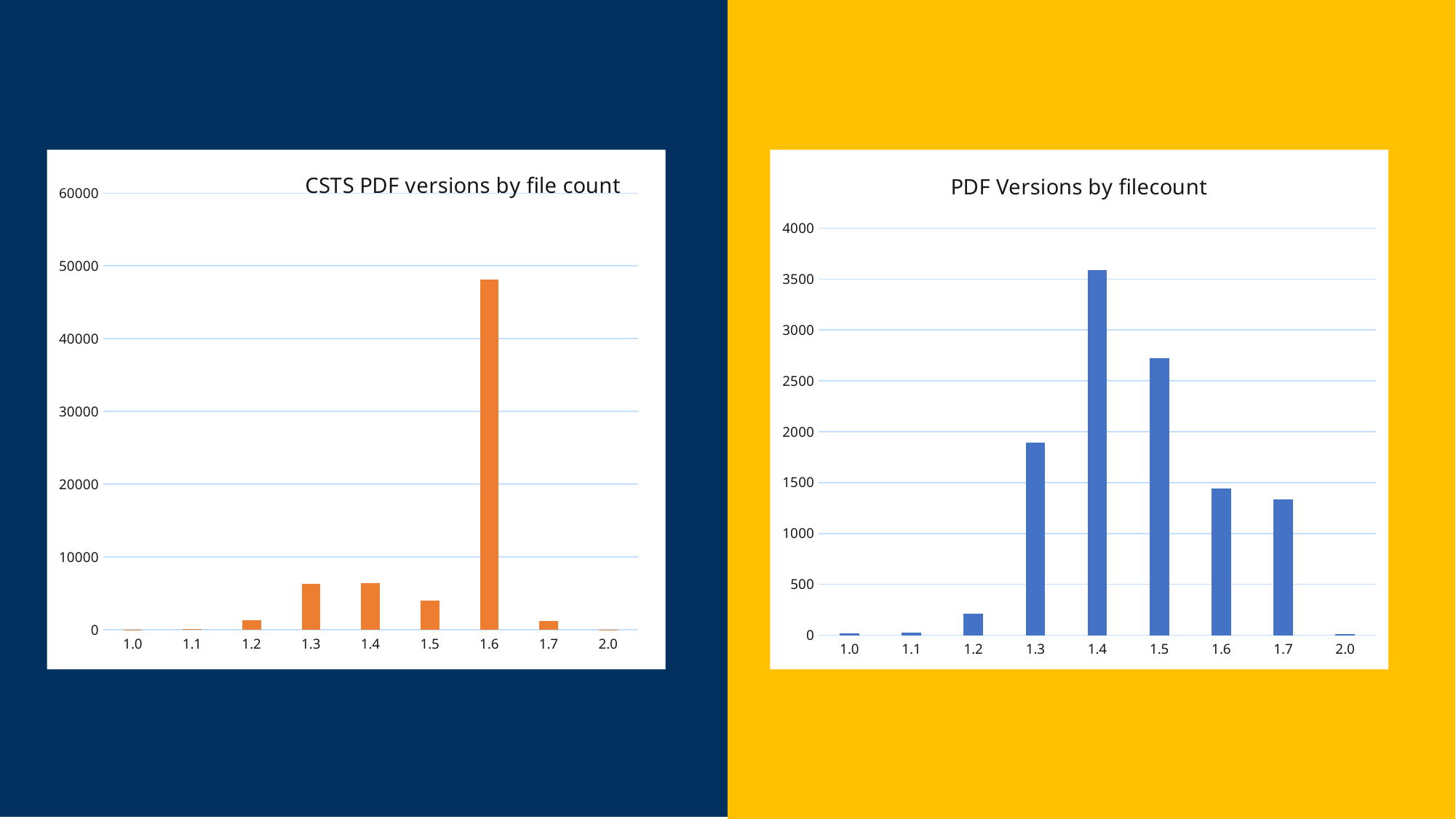
In the chart titled "CSTS PDF versions by file count", is the value for version 1.6 greater or less than 40000? greater In the chart titled "CSTS PDF versions by file count", is the value for version 1.3 greater or less than 10000? less In the chart titled "PDF Versions by filecount", which is larger, the value for version 1.3 or the value for version 1.5? 1.5 In the chart titled "PDF Versions by filecount", which PDF version has the highest file count? 1.4 In the chart titled "PDF Versions by filecount", is the value for version 1.3 greater or less than 2000? less What colour are the bars in the chart titled "PDF Versions by filecount"? blue How many PDF version categories are shown on the x axis of the chart titled "CSTS PDF versions by file count"? 9 In the chart titled "CSTS PDF versions by file count", which is larger, the value for version 1.5 or the value for version 1.6? 1.6 What type of chart is the chart titled "CSTS PDF versions by file count"? bar chart In the chart titled "CSTS PDF versions by file count", which PDF version has the highest file count? 1.6 How many PDF version categories are shown on the x axis of the chart titled "PDF Versions by filecount"? 9